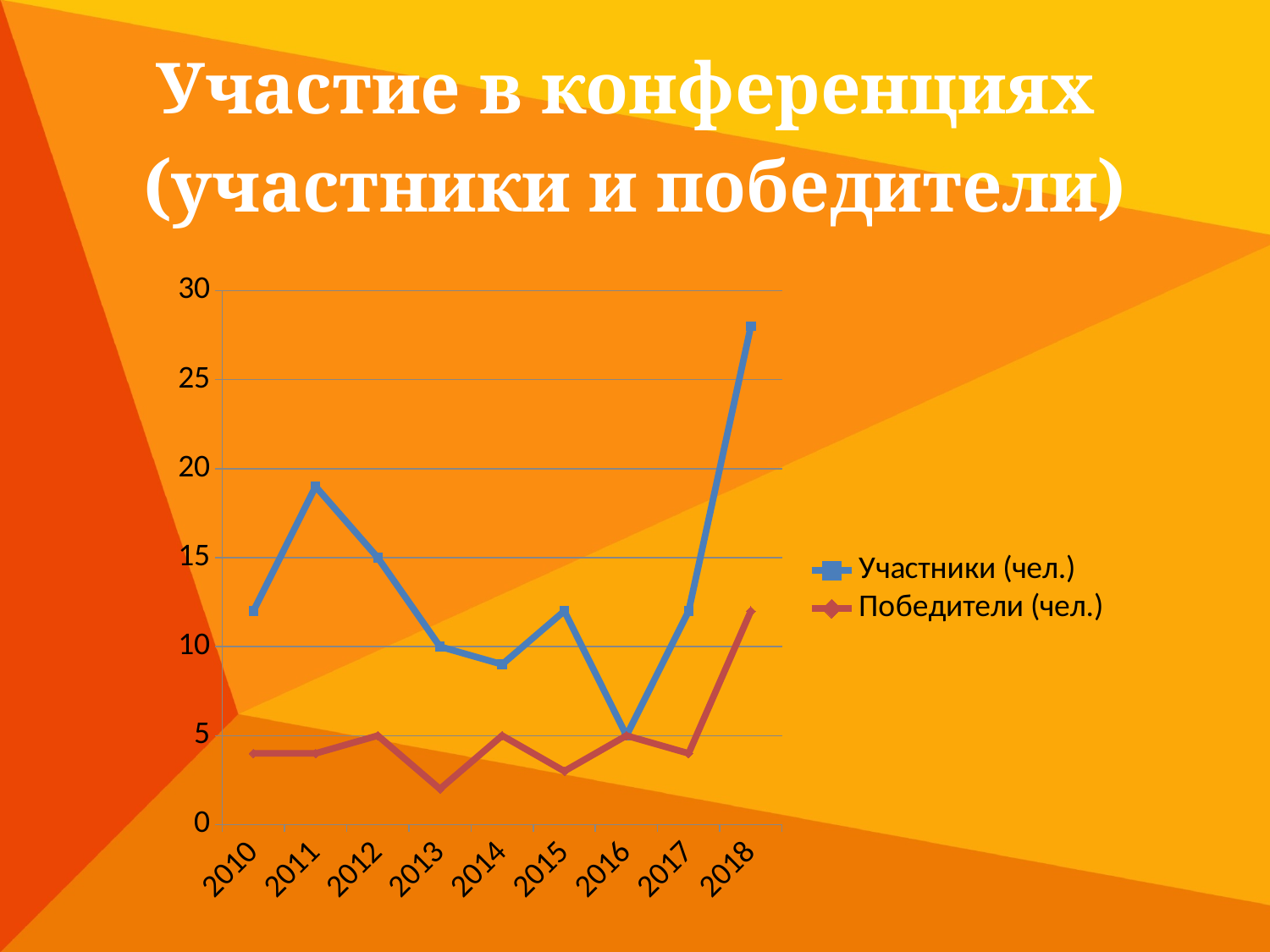
Which is larger for Участники (чел.): the value in 2011 or the value in 2012? 2011 How many series does the legend list? 2 In which year is the value for Участники (чел.) highest? 2018 What kind of chart is shown on the slide? line chart In which year is the value for Участники (чел.) lowest? 2016 In which year is the value for Победители (чел.) highest? 2018 In which year is the value for Победители (чел.) lowest? 2013 How many years are plotted along the x axis? 9 Is the value for Участники (чел.) in 2018 greater or less than 25? greater Is the value for Участники (чел.) in 2011 greater or less than 15? greater Do the values for Участники (чел.) rise or fall from 2016 to 2018? rise Is the value for Победители (чел.) in 2018 greater or less than 10? greater